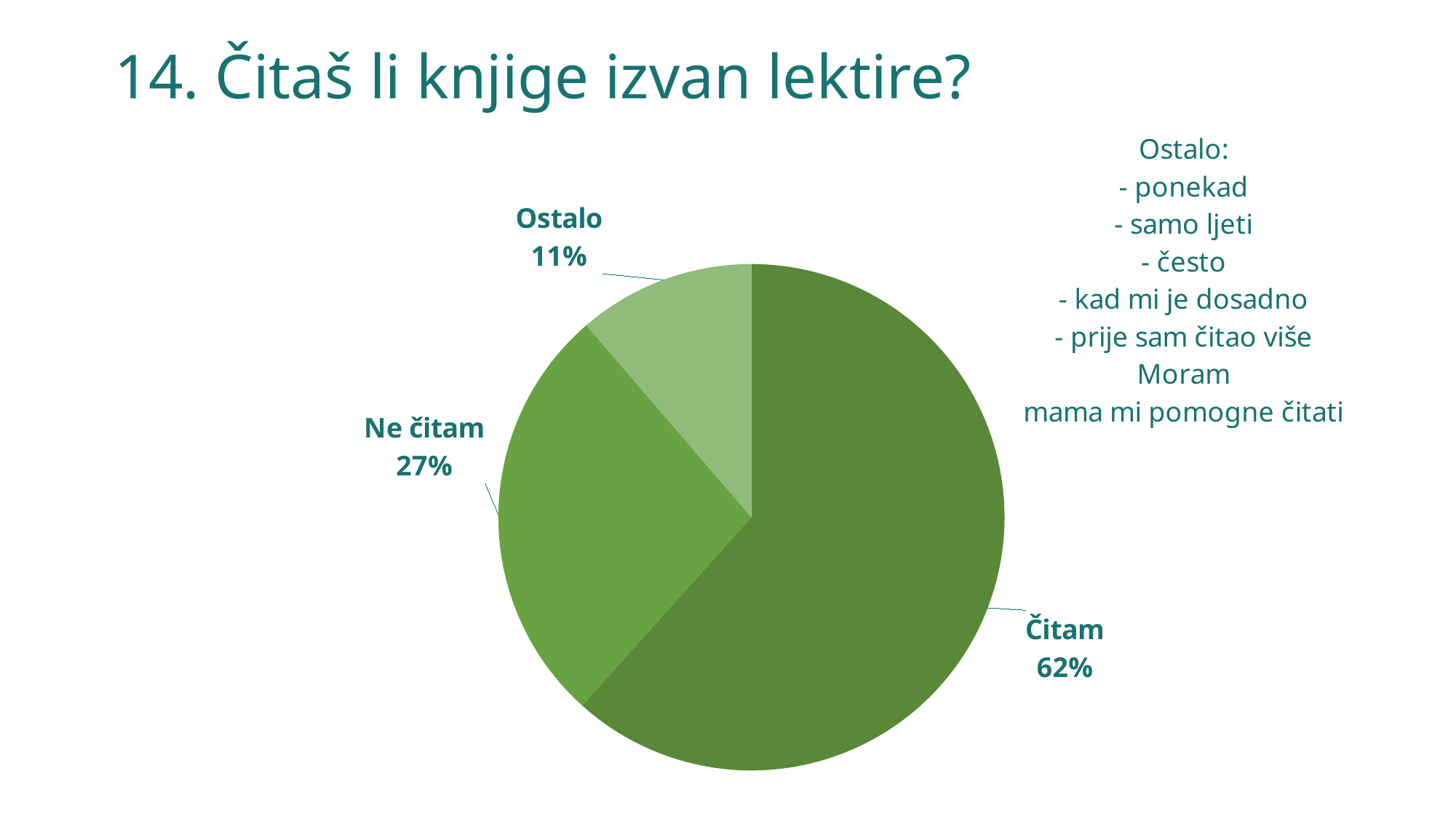
What is the difference in percentage points between "Ne čitam" and "Ostalo"? 16 Is the share for "Čitam" greater or less than 50%? greater What is the difference in percentage points between "Čitam" and "Ne čitam"? 35 What share of the pie does "Čitam" have? 62% What share of the pie does "Ostalo" have? 11% What share of the pie does "Ne čitam" have? 27% How many slices does the pie chart have? 3 Which category has the largest slice of the pie? Čitam Which is larger, the slice for "Ne čitam" or the slice for "Ostalo"? Ne čitam What is the title of the slide containing the pie chart? 14. Čitaš li knjige izvan lektire? What kind of chart is shown on the slide? pie chart Which category has the smallest slice of the pie? Ostalo